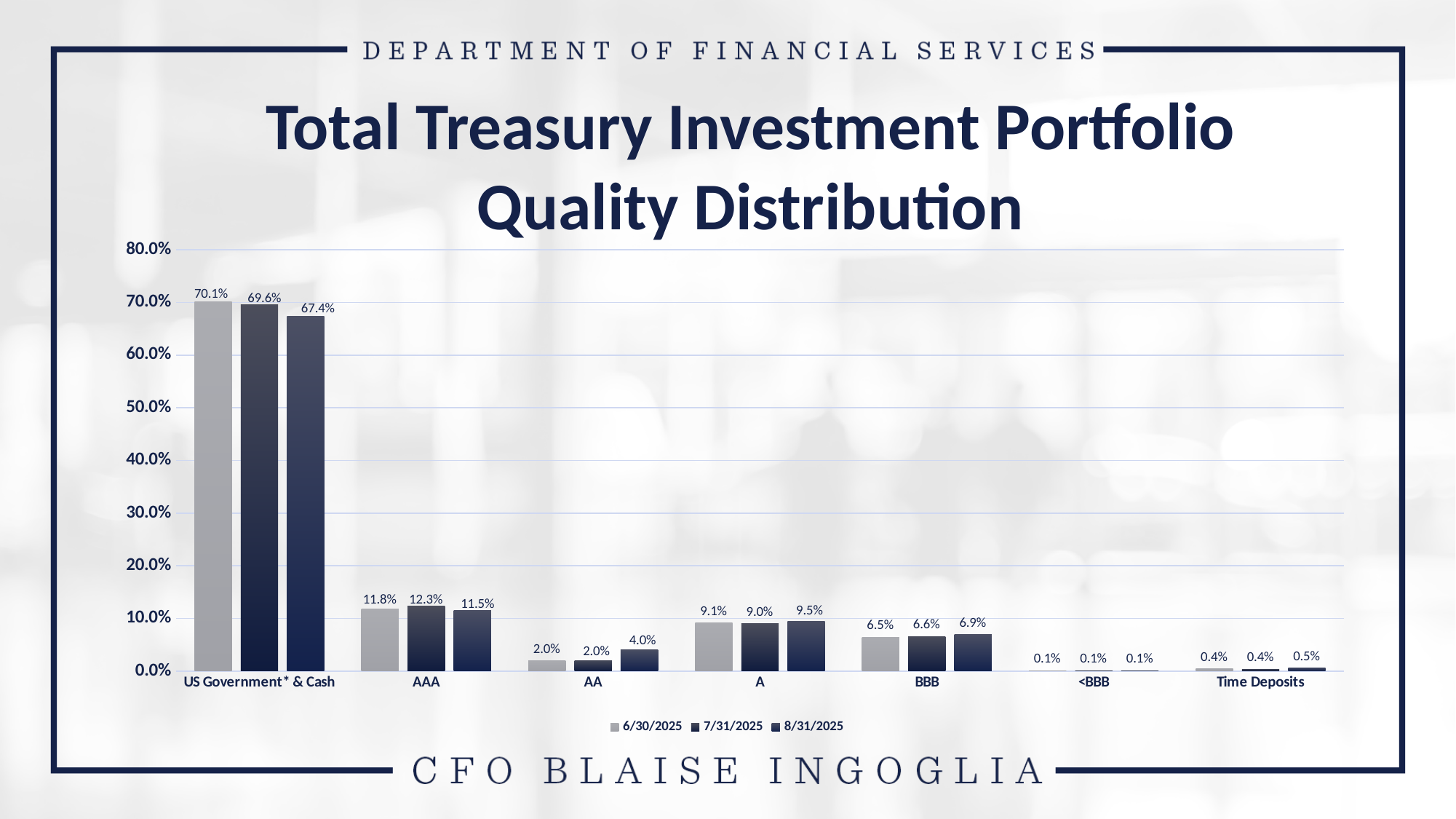
What is the value for AA in the 8/31/2025 series? 4.0% What is the value for AAA in the 7/31/2025 series? 12.3% Which is larger for category A: the 7/31/2025 value or the 8/31/2025 value? 8/31/2025 What is the difference between the 6/30/2025 and 8/31/2025 values for US Government* & Cash? 2.7% Which category has the highest value in the 8/31/2025 series? US Government* & Cash What kind of chart is shown on the slide? Bar chart How many series does the legend list? 3 What is the title of the chart? Total Treasury Investment Portfolio Quality Distribution Which category has the lowest value in the 6/30/2025 series? <BBB How many categories are shown on the x axis? 7 What is the value for Time Deposits in the 8/31/2025 series? 0.5% What is the value for US Government* & Cash in the 6/30/2025 series? 70.1%